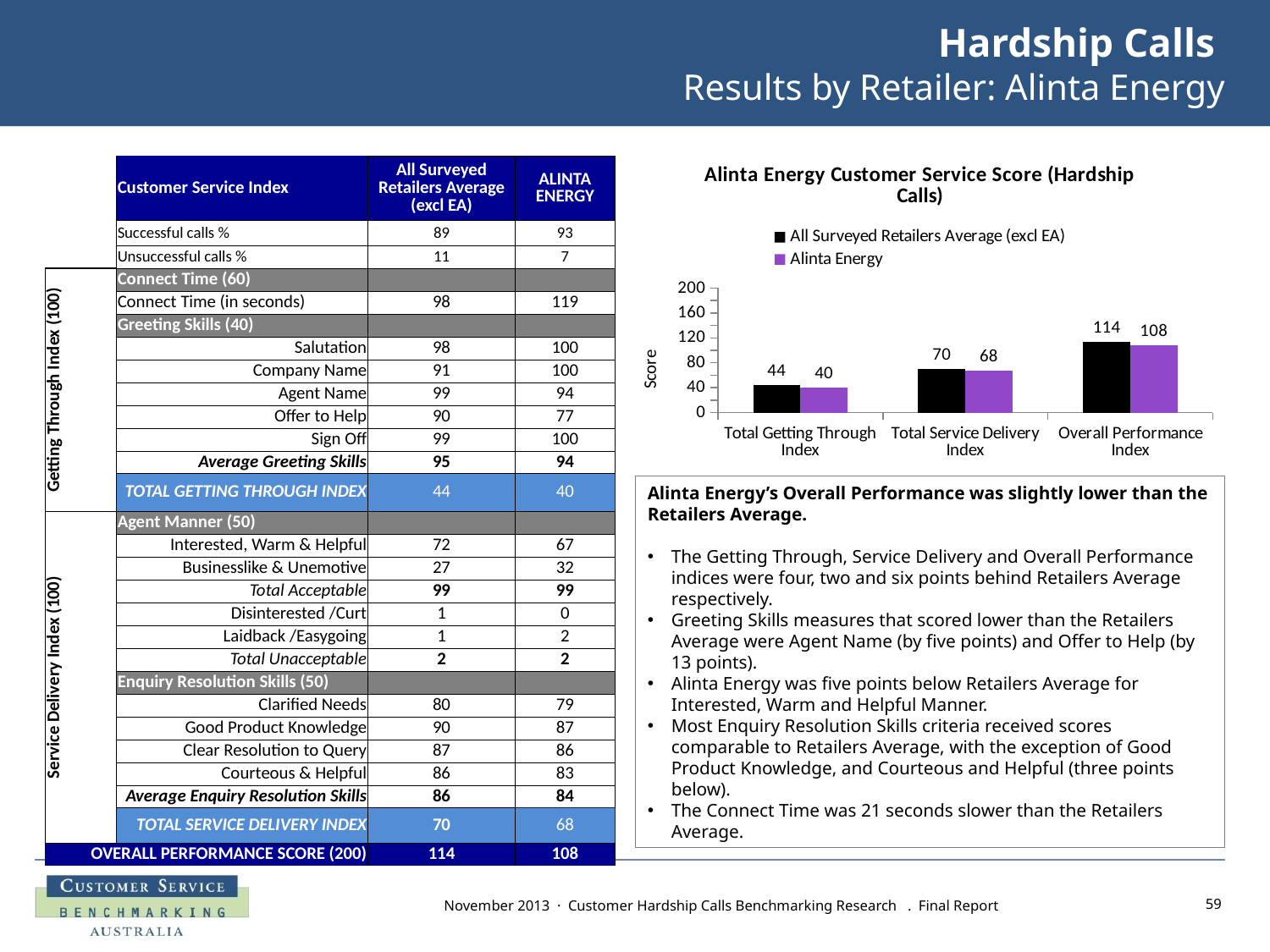
What is the difference between the All Surveyed Retailers Average (excl EA) and Alinta Energy values for Overall Performance Index? 6 Do the Alinta Energy values rise or fall from left to right across the x axis? rise What is the All Surveyed Retailers Average (excl EA) value for Total Service Delivery Index? 70 For Total Getting Through Index, which is larger: the All Surveyed Retailers Average (excl EA) or Alinta Energy? All Surveyed Retailers Average (excl EA) Which category has the highest All Surveyed Retailers Average (excl EA) value? Overall Performance Index What type of chart is shown on the slide? bar chart Which category has the lowest Alinta Energy value? Total Getting Through Index How many categories are shown on the x axis of the chart? 3 What is the Alinta Energy value for Overall Performance Index? 108 How many series does the chart legend list? 2 What is the title of the chart on the slide? Alinta Energy Customer Service Score (Hardship Calls) What is the Alinta Energy value for Total Getting Through Index? 40